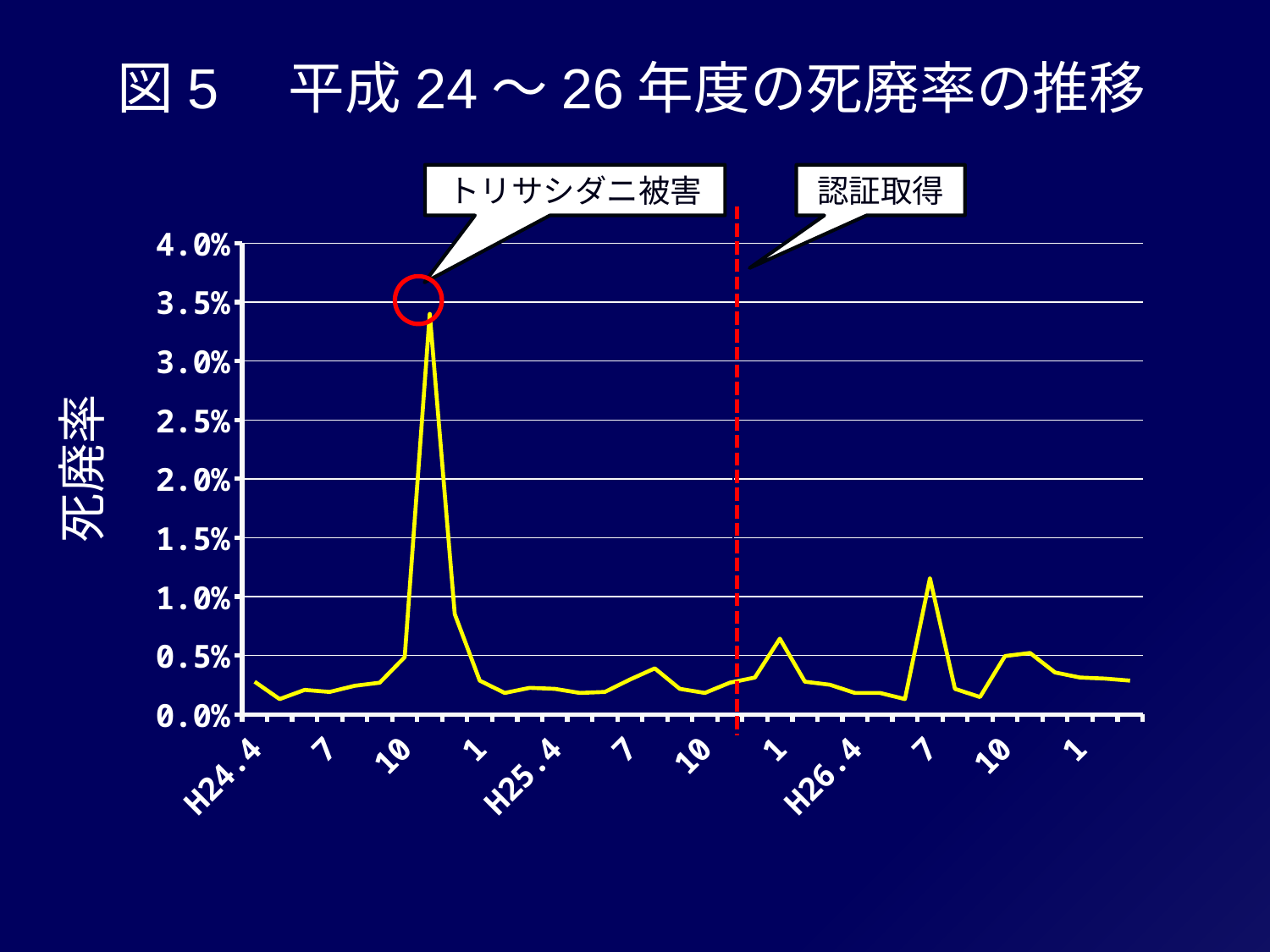
What is the highest value shown on the vertical axis of the chart? 4.0% What kind of chart is shown on the slide? line chart Is the value for H26.7 greater or less than 0.5%? greater What is the title of the chart on the slide? 図５ 平成24～26年度の死廃率の推移 Which is larger, the value at the peak near H24.10–H25.1 or the value at the peak at H26.7? the peak near H24.10–H25.1 Which annotation label points to the highest peak of the line? トリサシダニ被害 Is the value at the highest peak of the line greater or less than 3.0%? greater Is the value for H25.4 greater or less than 0.5%? less What label is shown on the vertical axis of the chart? 死廃率 How many labels are printed along the x axis of the chart? 12